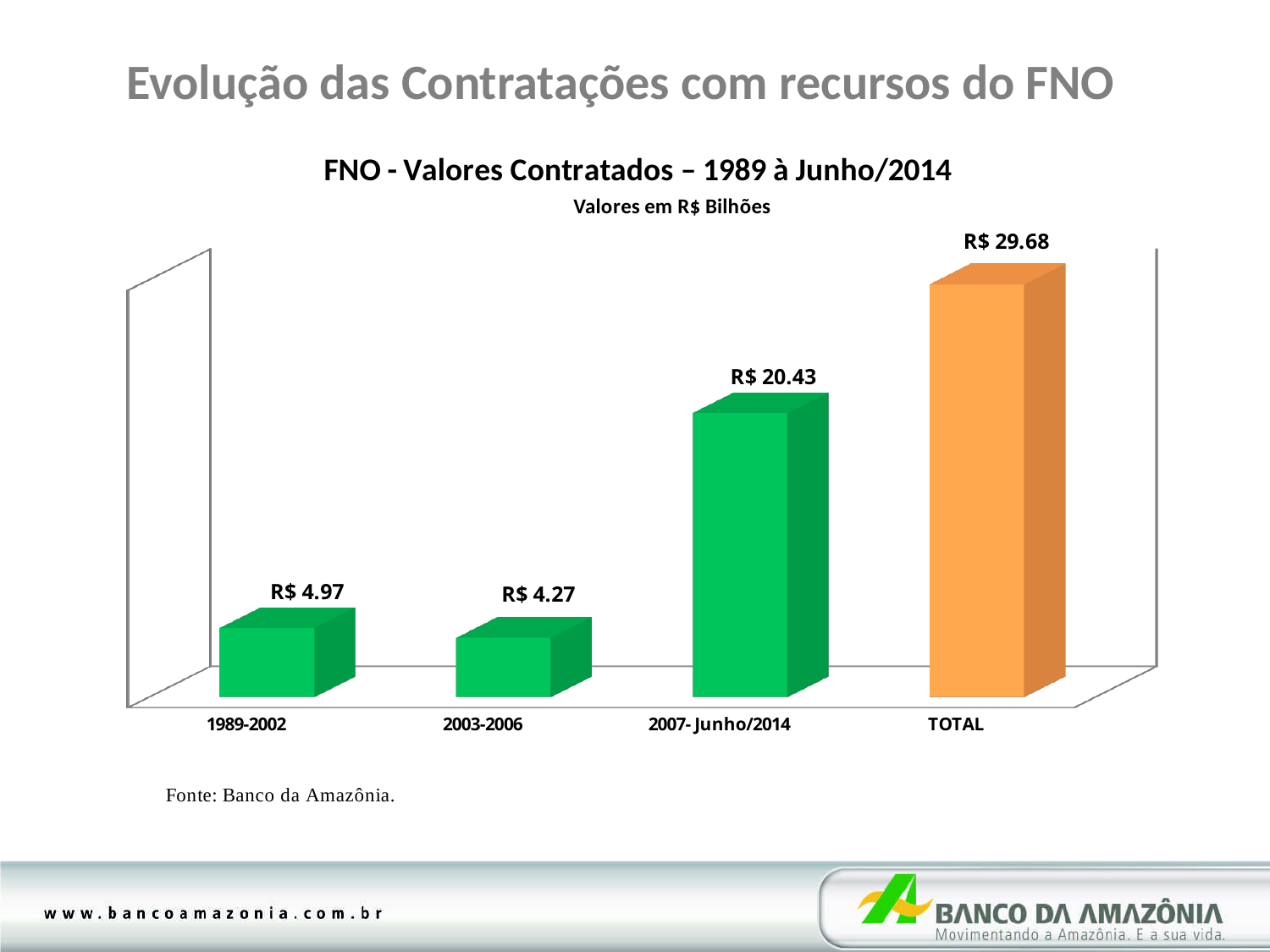
Which category has the highest value? TOTAL Which is larger, the value for 2007- Junho/2014 or the value for 1989-2002? 2007- Junho/2014 What is the difference between the values for TOTAL and 2007- Junho/2014? R$ 9.25 What kind of chart is this? Bar chart What is the title of the chart? FNO - Valores Contratados – 1989 à Junho/2014 What is the value for TOTAL? R$ 29.68 Which category has the lowest value? 2003-2006 What is the difference between the values for 1989-2002 and 2003-2006? R$ 0.70 What is the value for 1989-2002? R$ 4.97 What is the value for 2007- Junho/2014? R$ 20.43 How many categories are shown on the x axis? 4 What is the value for 2003-2006? R$ 4.27